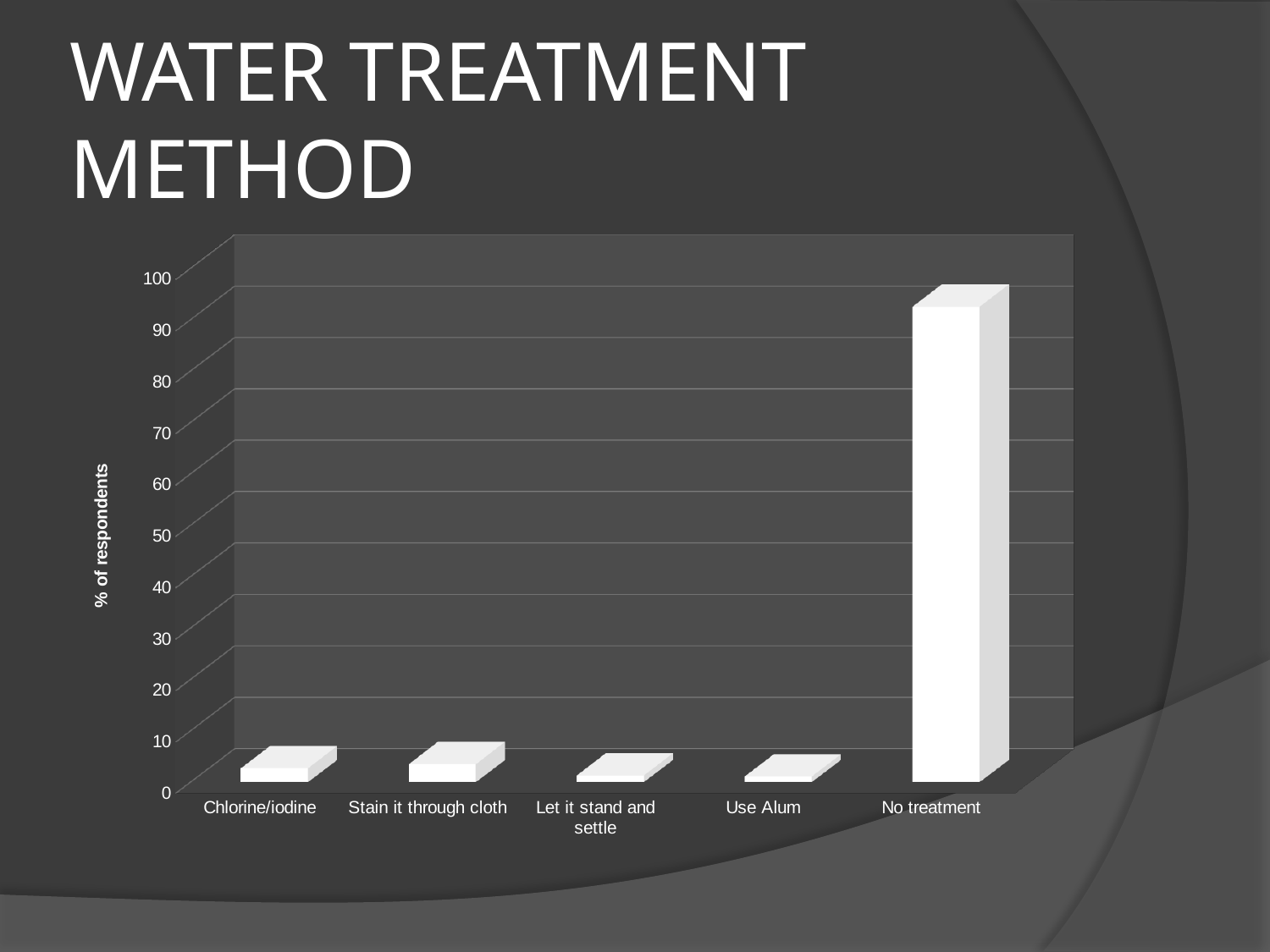
Is the value for Let it stand and settle greater or less than 20? less Which is larger, the value for Stain it through cloth or the value for Use Alum? Stain it through cloth What kind of chart is shown on the slide? bar chart Which is larger, the value for No treatment or the value for Chlorine/iodine? No treatment Is the value for Use Alum greater or less than 10? less Is the value for Stain it through cloth greater or less than 10? less Which water treatment method has the highest percentage of respondents? No treatment What is the label on the vertical axis of the chart? % of respondents What is the title of the slide containing the chart? WATER TREATMENT METHOD How many water treatment method categories are shown on the x axis? 5